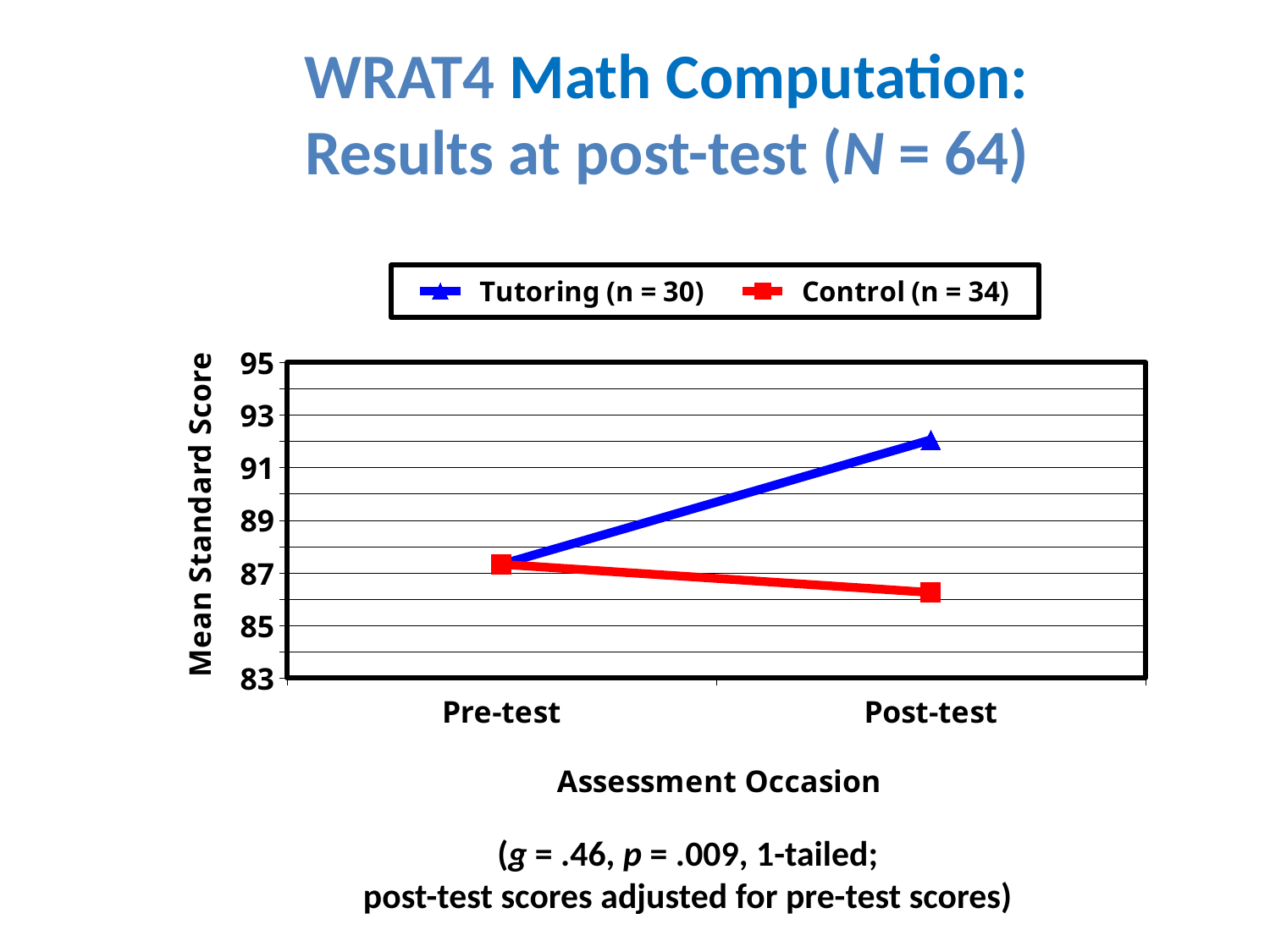
How many series does the legend list? 2 Is the Post-test value for Tutoring (n = 30) greater or less than 93? less At Post-test, which group has the higher mean standard score, Tutoring (n = 30) or Control (n = 34)? Tutoring (n = 30) What is the label of the y axis? Mean Standard Score Does the Tutoring (n = 30) line rise or fall from Pre-test to Post-test? rise Is the Post-test value for Control (n = 34) greater or less than 87? less Does the Control (n = 34) line rise or fall from Pre-test to Post-test? fall How many assessment occasions are plotted on the x axis? 2 Is the Post-test value for Tutoring (n = 30) greater or less than 91? greater What kind of chart is shown on the slide? line chart What colour is the line for Control (n = 34)? red